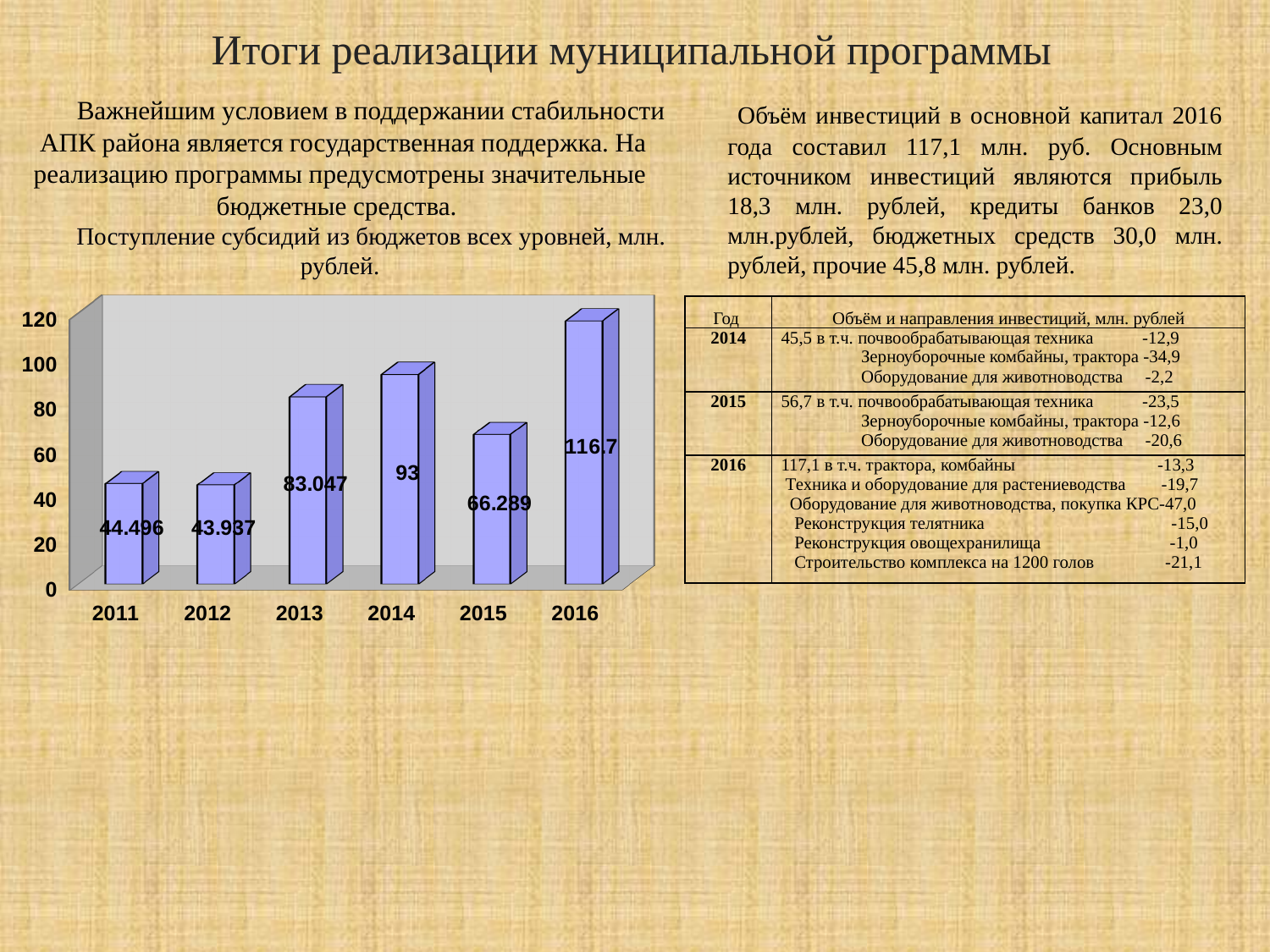
Which year has the highest value in the bar chart? 2016 Which year has the lowest value in the bar chart? 2012 What is the value for 2016 in the bar chart? 116.7 What is the value for 2015 in the bar chart? 66.289 What kind of chart is shown on the slide? bar chart How many years are shown on the x axis of the bar chart? 6 Is the value for 2014 in the bar chart greater or less than 80? greater Does the value in the bar chart rise or fall from 2014 to 2015? fall What is the difference between the values for 2016 and 2014 in the bar chart? 23.7 Which is larger in the bar chart, the value for 2013 or the value for 2015? 2013 What is the value for 2013 in the bar chart? 83.047 What is the value for 2011 in the bar chart? 44.496